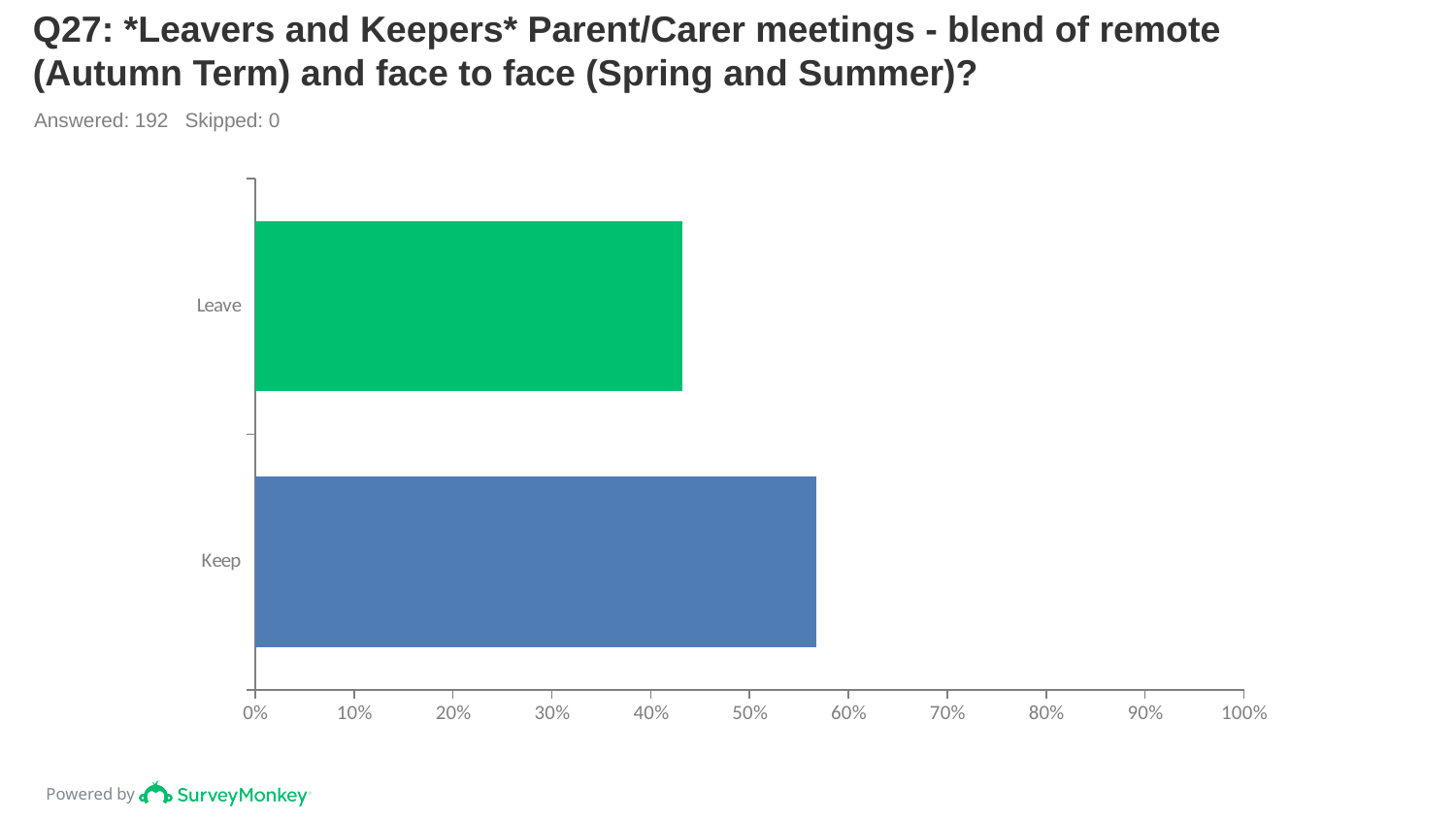
What is the highest value shown on the x axis? 100% Is the value for Keep greater or less than 60%? less Which category has the lowest value? Leave Is the value for Leave greater or less than 50%? less Is the value for Keep greater or less than 50%? greater What kind of chart is shown on the slide? bar chart Which category has the highest value? Keep Which is larger, the value for Leave or the value for Keep? Keep How many categories are plotted in the chart? 2 What colour is the bar for Leave? green